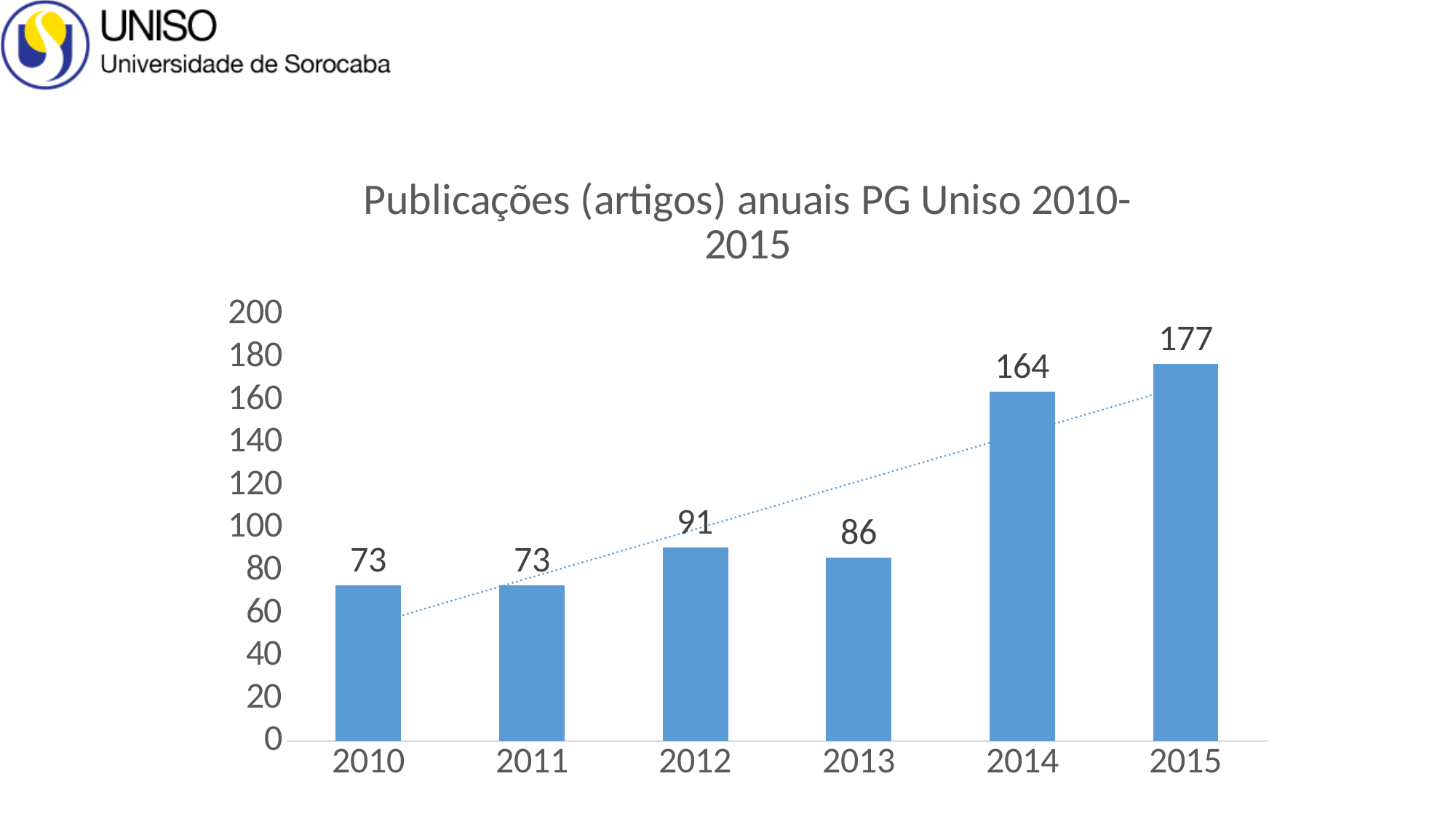
What is the value for 2012? 91 Do the values generally rise or fall from 2010 to 2015? rise Is the value for 2014 greater or less than 140? greater What kind of chart is shown on the slide? bar chart What is the title of the chart? Publicações (artigos) anuais PG Uniso 2010-2015 What is the value for 2014? 164 Which year has the highest value? 2015 Which is larger, the value for 2012 or the value for 2013? 2012 What is the difference between the values for 2015 and 2014? 13 How many years are shown on the x axis? 6 What is the difference between the values for 2012 and 2010? 18 What is the value for 2013? 86